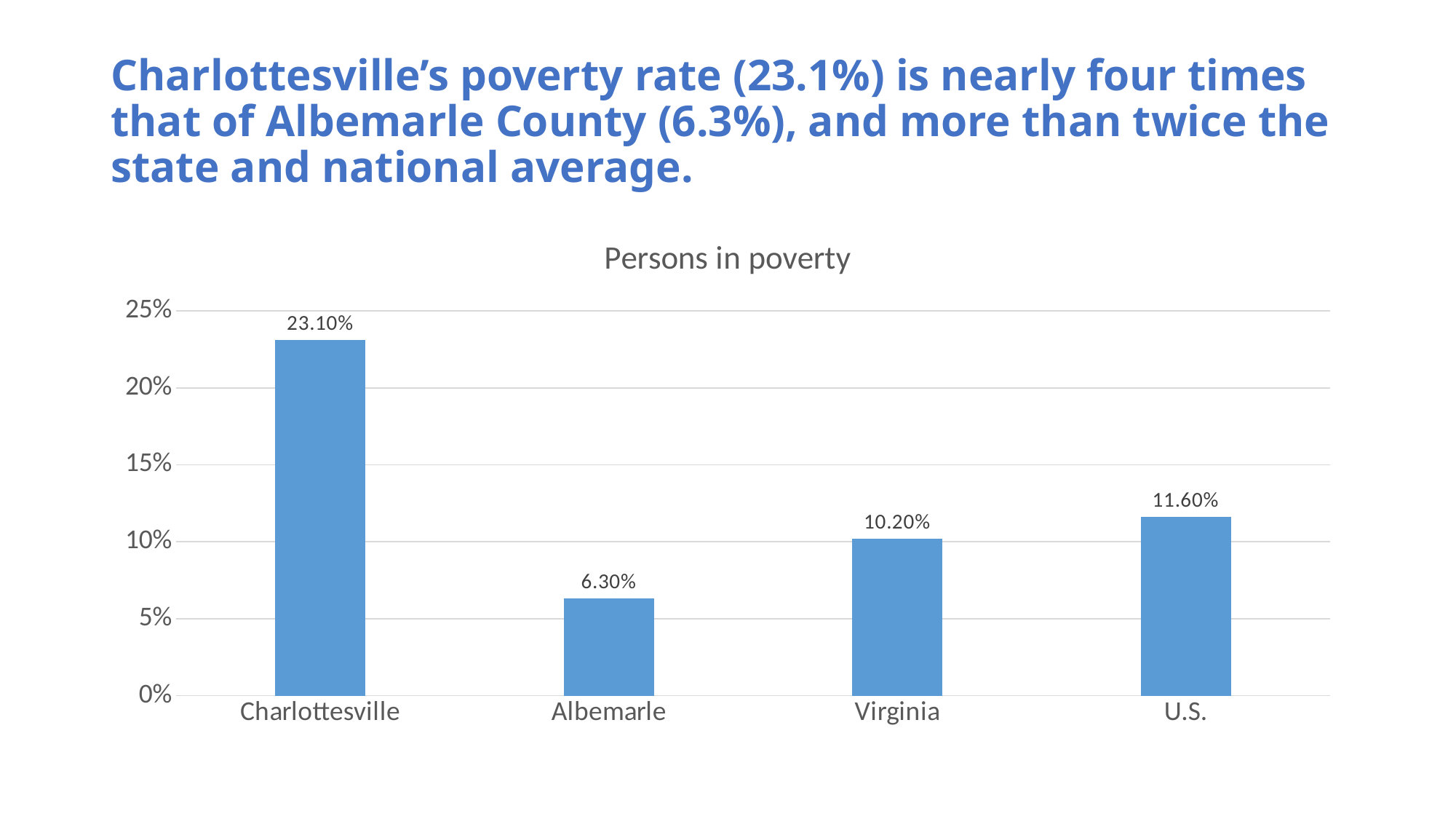
What is the title of the chart? Persons in poverty What is the value for Charlottesville? 23.10% What is the value for Albemarle? 6.30% How many categories are shown on the x axis? 4 Which category has the highest value? Charlottesville What is the value for Virginia? 10.20% What is the value for U.S.? 11.60% Which category has the lowest value? Albemarle What is the difference between the values for U.S. and Virginia? 1.40% Is the value for Charlottesville greater or less than 20%? greater What is the difference between the values for Charlottesville and Albemarle? 16.80% Which is larger, the value for Virginia or the value for U.S.? U.S.